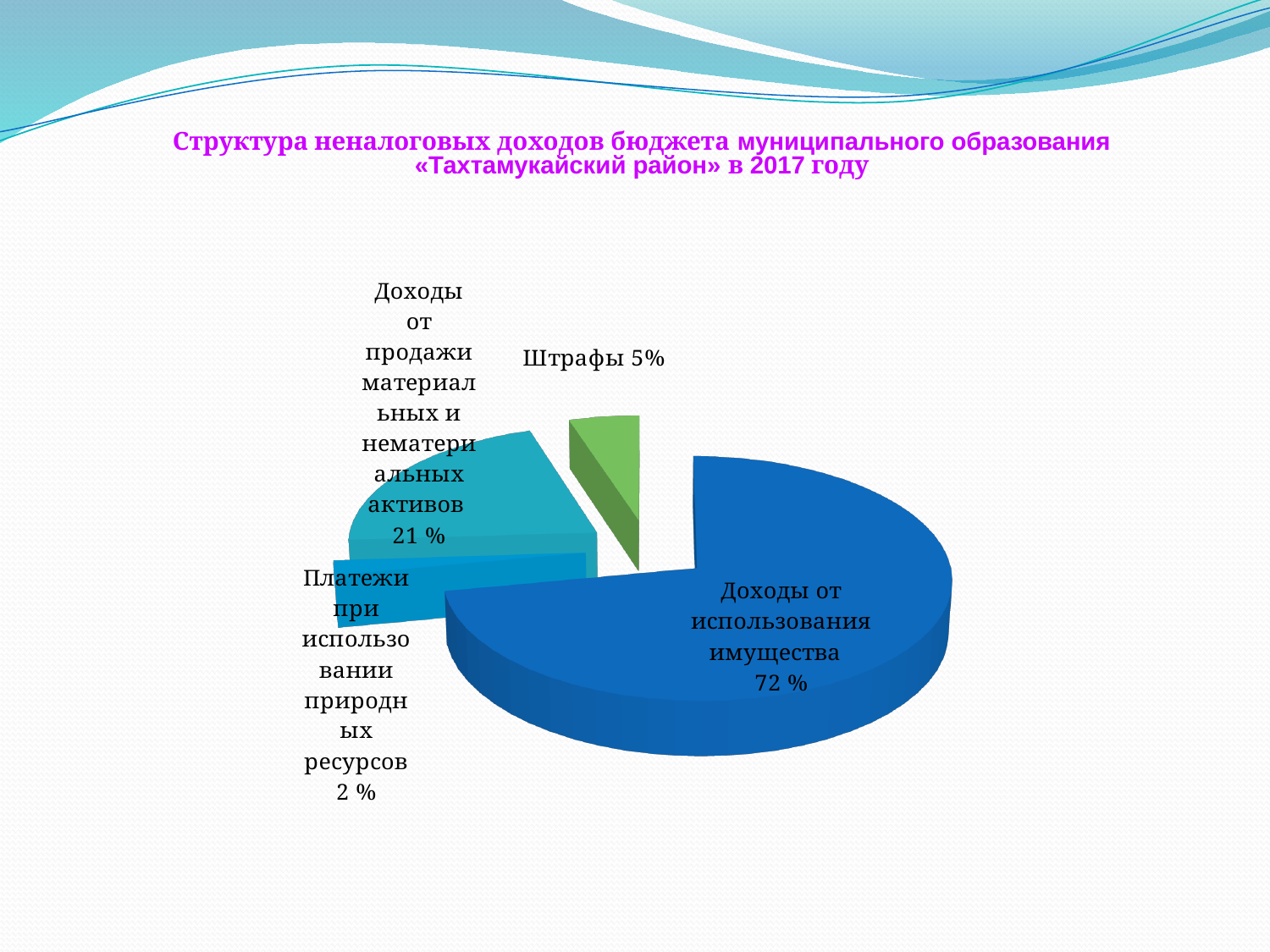
What is the difference in percentage points between «Доходы от использования имущества» and «Доходы от продажи материальных и нематериальных активов»? 51 What year does the chart title refer to? 2017 What share is shown for «Штрафы»? 5% How many slices does the pie chart have? 4 What is the difference in percentage points between «Штрафы» and «Платежи при использовании природных ресурсов»? 3 Which category has the smallest share of the pie? Платежи при использовании природных ресурсов What share is shown for «Платежи при использовании природных ресурсов»? 2 % What share is shown for «Доходы от продажи материальных и нематериальных активов»? 21 % Which category has the largest share of the pie? Доходы от использования имущества Which is larger: the share for «Штрафы» or the share for «Платежи при использовании природных ресурсов»? Штрафы What share of non-tax revenues comes from «Доходы от использования имущества»? 72 % What type of chart is shown on the slide? Pie chart